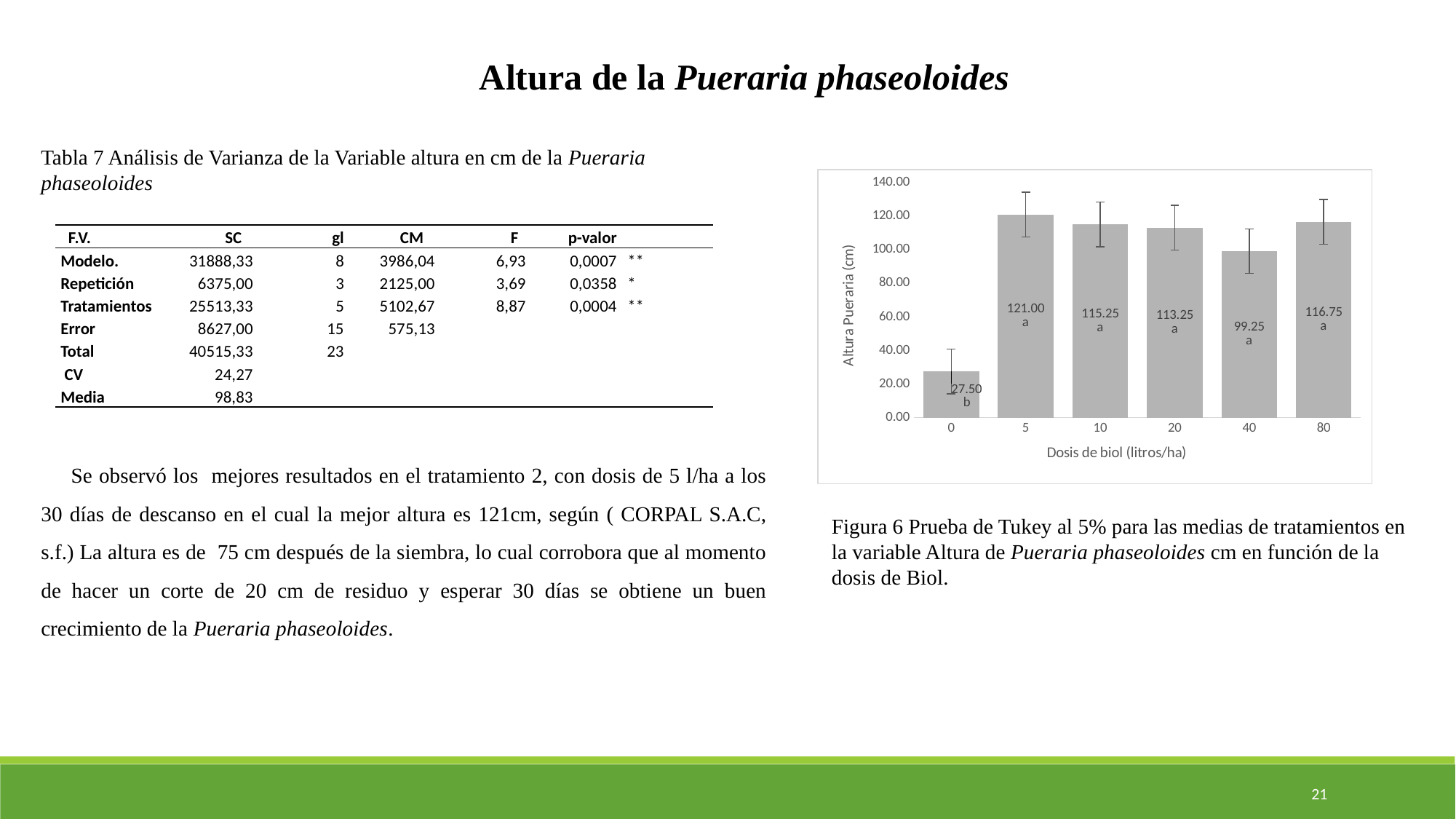
Is the value for the 20 litros/ha dose greater or less than 100.00? greater What is the label of the y axis of the chart? Altura Pueraria (cm) How many dose categories are shown on the x axis of the chart? 6 Which dose of biol has the highest height value? 5 Which has a larger height value, the 10 litros/ha dose or the 40 litros/ha dose? 10 What type of chart is shown on the slide? bar chart What is the difference between the height values for the 5 and 0 litros/ha doses? 93.50 What is the height value for the 0 litros/ha dose of biol? 27.50 Which dose of biol has the lowest height value? 0 What is the height value for the 40 litros/ha dose of biol? 99.25 What is the height value for the 80 litros/ha dose of biol? 116.75 What is the height value for the 5 litros/ha dose of biol? 121.00